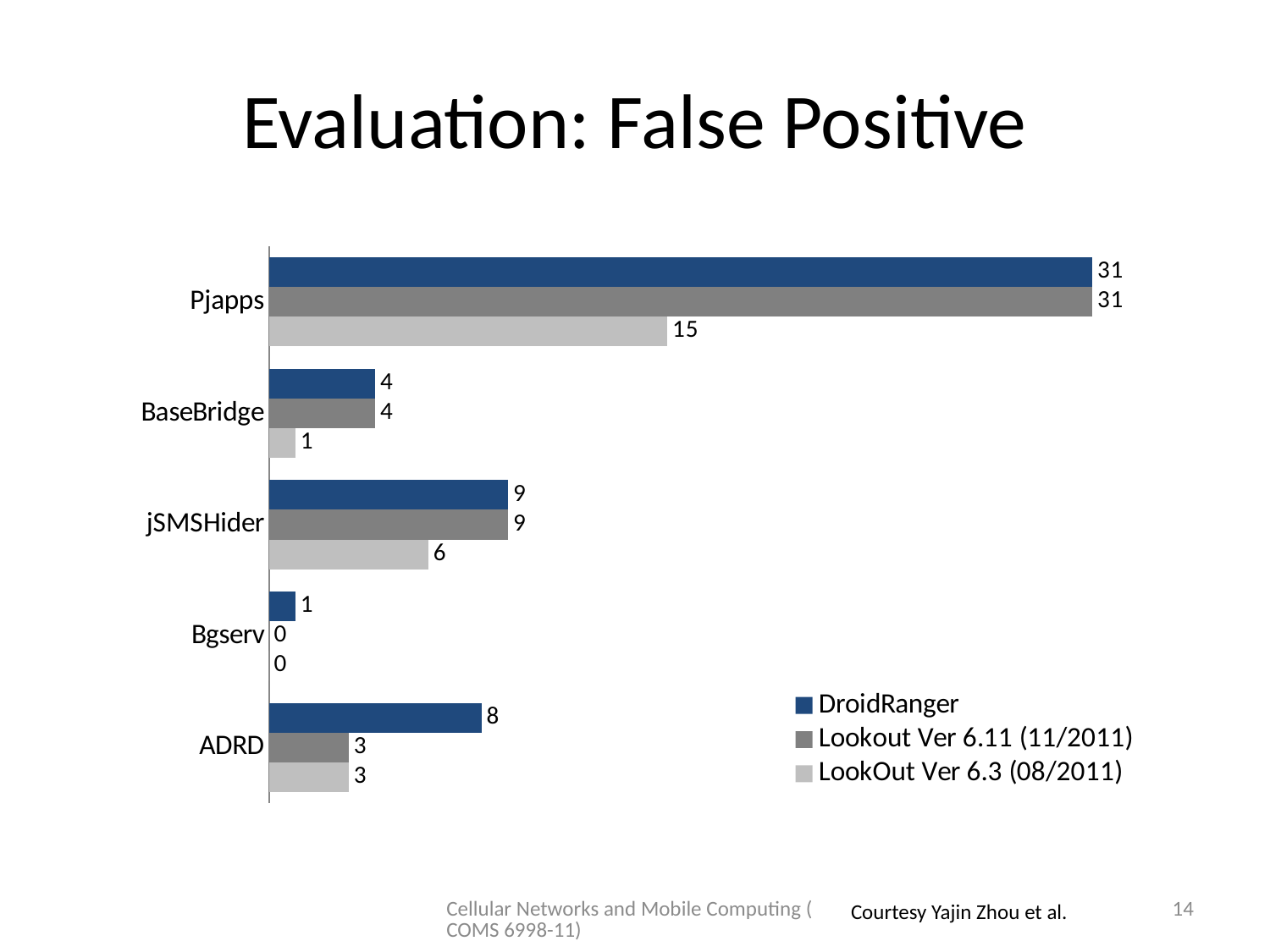
For ADRD, which is larger: the DroidRanger value or the Lookout Ver 6.11 (11/2011) value? DroidRanger What kind of chart is shown on the slide? Bar chart Which category has the lowest DroidRanger value? Bgserv How many series does the legend list? 3 What is the title of the slide containing the chart? Evaluation: False Positive What is the LookOut Ver 6.3 (08/2011) value for jSMSHider? 6 What is the difference between the DroidRanger and LookOut Ver 6.3 (08/2011) values for Pjapps? 16 What is the DroidRanger value for Pjapps? 31 What is the difference between the DroidRanger and LookOut Ver 6.3 (08/2011) values for BaseBridge? 3 How many categories are shown on the chart? 5 What is the Lookout Ver 6.11 (11/2011) value for ADRD? 3 Which category has the highest DroidRanger value? Pjapps